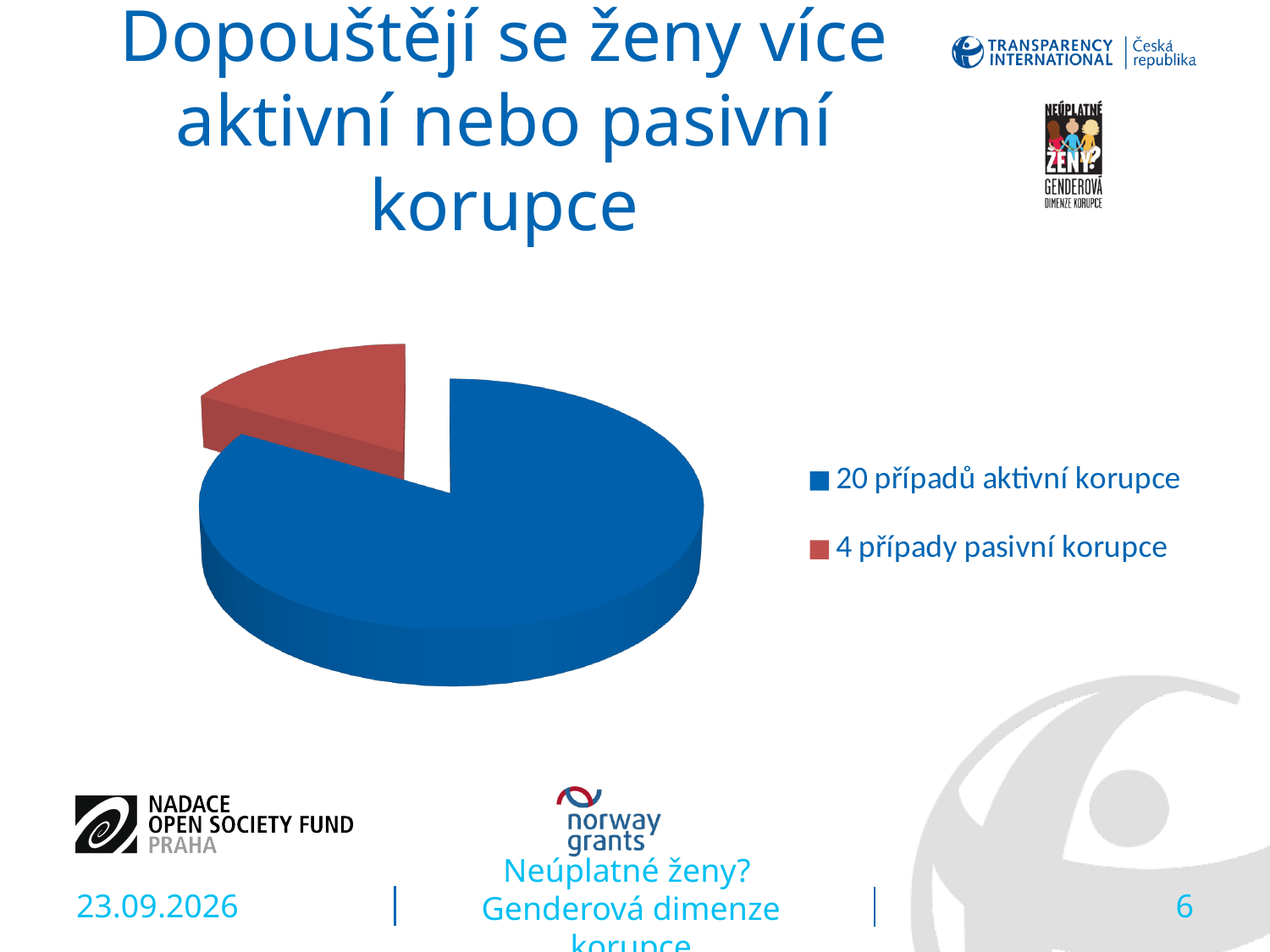
How many entries does the legend of the pie chart list? 2 What kind of chart is shown on the slide? pie chart What colour is the slice representing the 20 cases of active corruption? blue Are there more cases of active corruption or passive corruption? active corruption (aktivní korupce) Which category has the larger slice of the pie: aktivní korupce or pasivní korupce? aktivní korupce What is the total number of cases represented in the pie chart? 24 How many cases of active corruption (aktivní korupce) does the chart report? 20 How many slices does the pie chart have? 2 What is the difference between the number of active corruption cases and passive corruption cases? 16 What colour is the slice representing the 4 cases of passive corruption? red How many cases of passive corruption (pasivní korupce) does the chart report? 4 Which category has the smaller slice of the pie? pasivní korupce